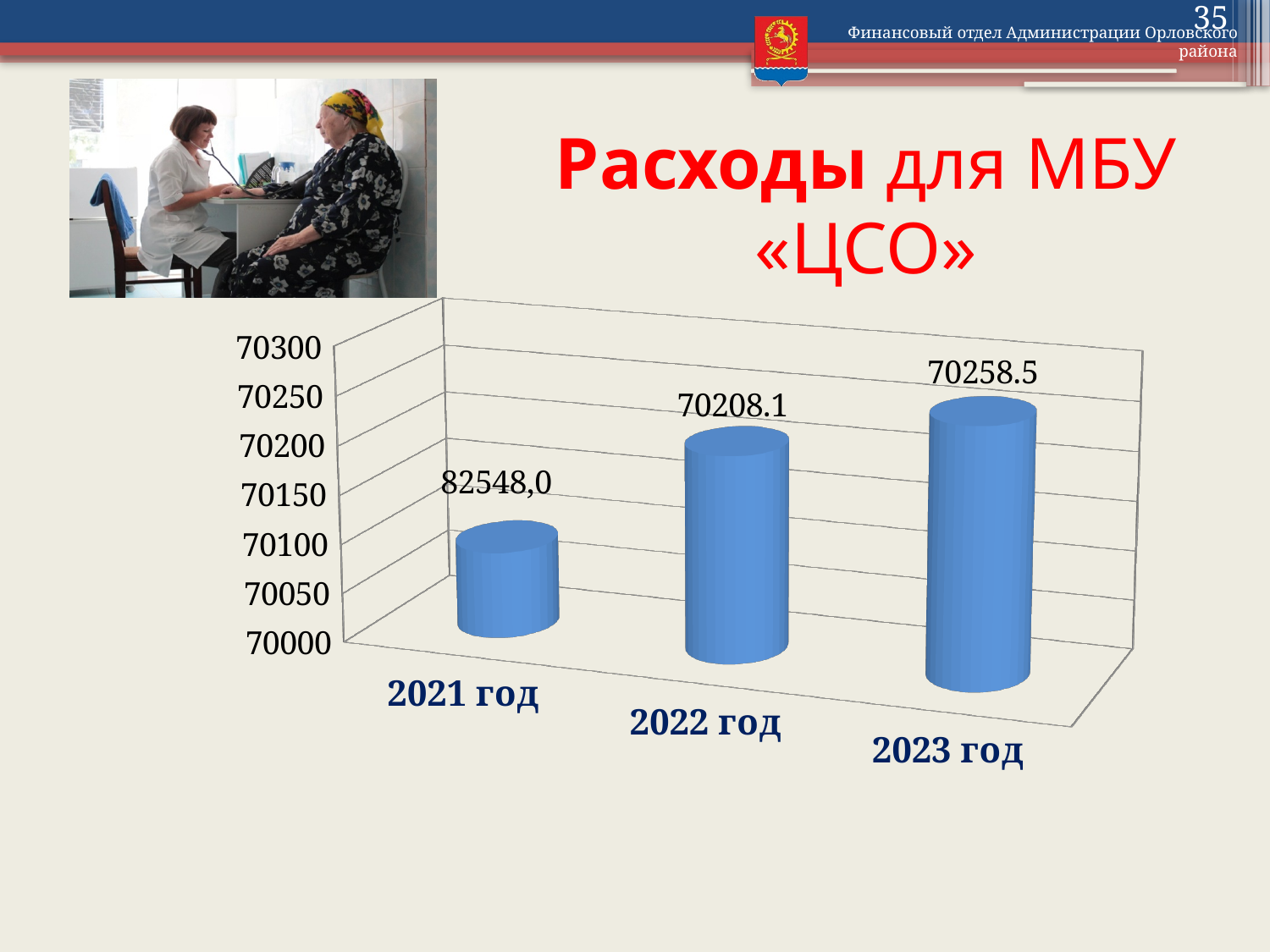
What is the value shown for 2023 год? 70258.5 Which is larger, the value for 2022 год or the value for 2023 год? 2023 год What is the title of the slide above the chart? Расходы для МБУ «ЦСО» How many categories (years) are shown on the chart? 3 What colour are the bars in the chart? blue What kind of chart is shown on the slide? bar chart Is the value for 2023 год greater or less than 70200? greater What is the difference between the values for 2023 год and 2022 год? 50.4 What is the value shown for 2022 год? 70208.1 Is the value for 2022 год greater or less than 70150? greater What data label is printed above the bar for 2021 год? 82548,0